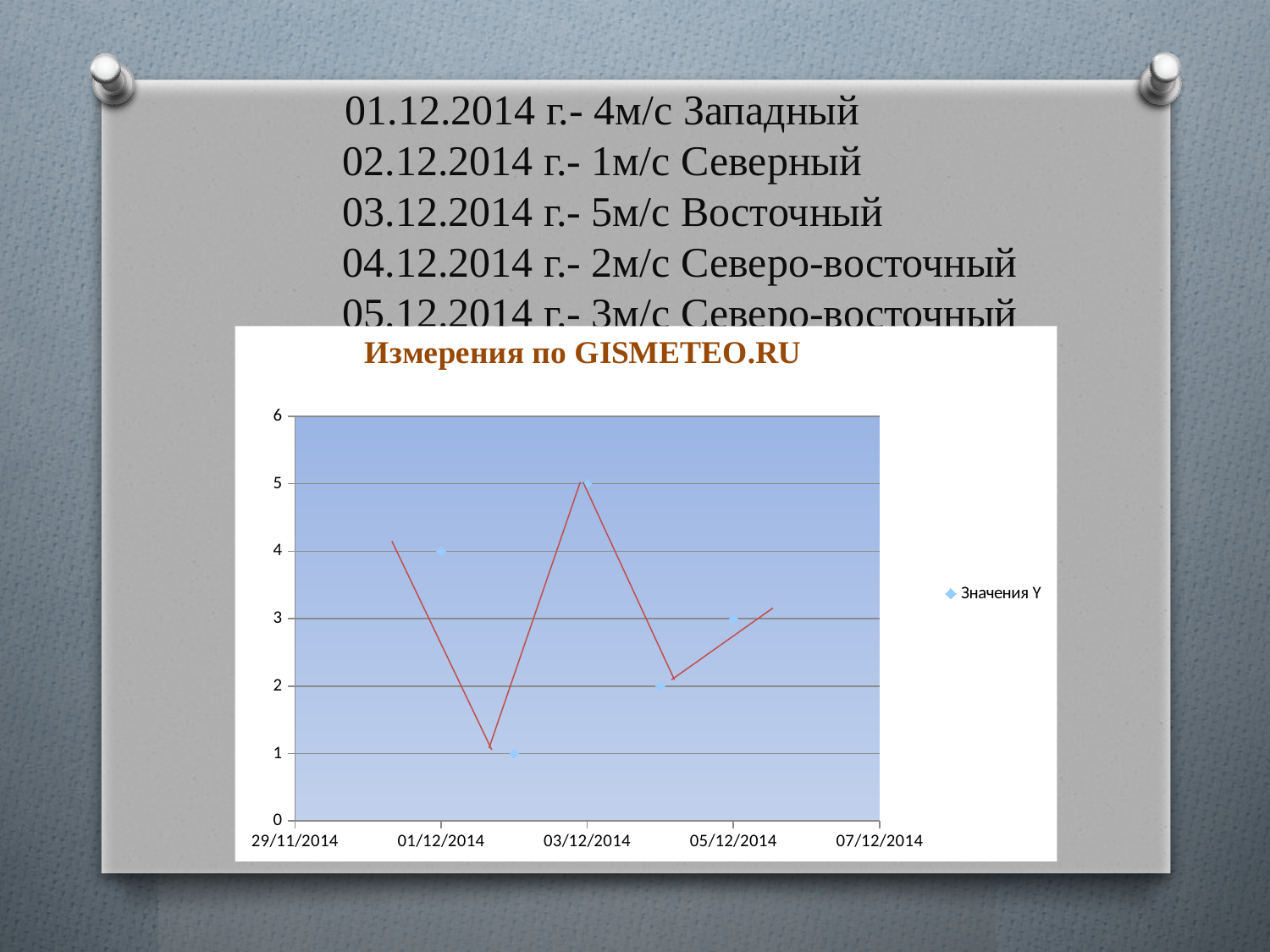
What is the title of the chart? Измерения по GISMETEO.RU On which date is the value of Значения Y lowest? 02/12/2014 On which date is the value of Значения Y highest? 03/12/2014 What is the value of Значения Y on 03/12/2014? 5 What is the value of Значения Y on 01/12/2014? 4 What is the value of Значения Y on 02/12/2014? 1 What is the difference between the values on 03/12/2014 and 02/12/2014? 4 What is the value of Значения Y on 05/12/2014? 3 How many data points are plotted in the chart? 5 Does the value rise or fall from 03/12/2014 to 04/12/2014? fall How many series does the legend list? 1 Which date has the larger value, 01/12/2014 or 05/12/2014? 01/12/2014